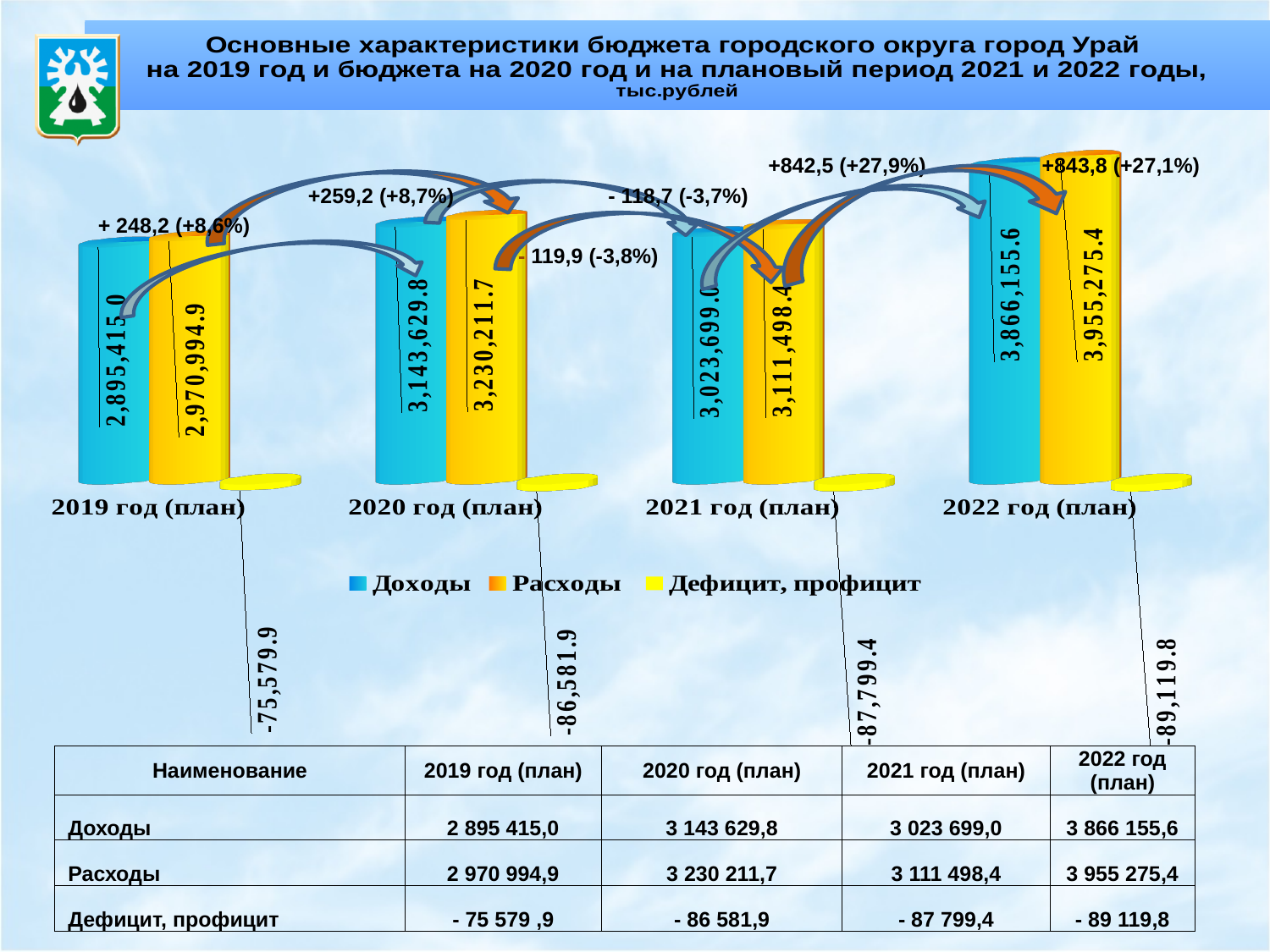
Which is larger: Доходы for 2020 год (план) or Доходы for 2021 год (план)? 2020 год (план) What is the difference between Расходы and Доходы for 2022 год (план)? 89,119.8 What is the value of Доходы for 2019 год (план)? 2,895,415.0 What is the value of Расходы for 2022 год (план)? 3,955,275.4 In which year are Расходы the lowest? 2019 год (план) What is the value of Расходы for 2021 год (план)? 3,111,498.4 What kind of chart is shown on the slide? Bar chart In which year are Доходы the highest? 2022 год (план) How many year categories are shown on the chart? 4 What is the value of Дефицит, профицит for 2020 год (план)? -86,581.9 Which legend entry is shown in blue? Доходы How many series does the legend list? 3